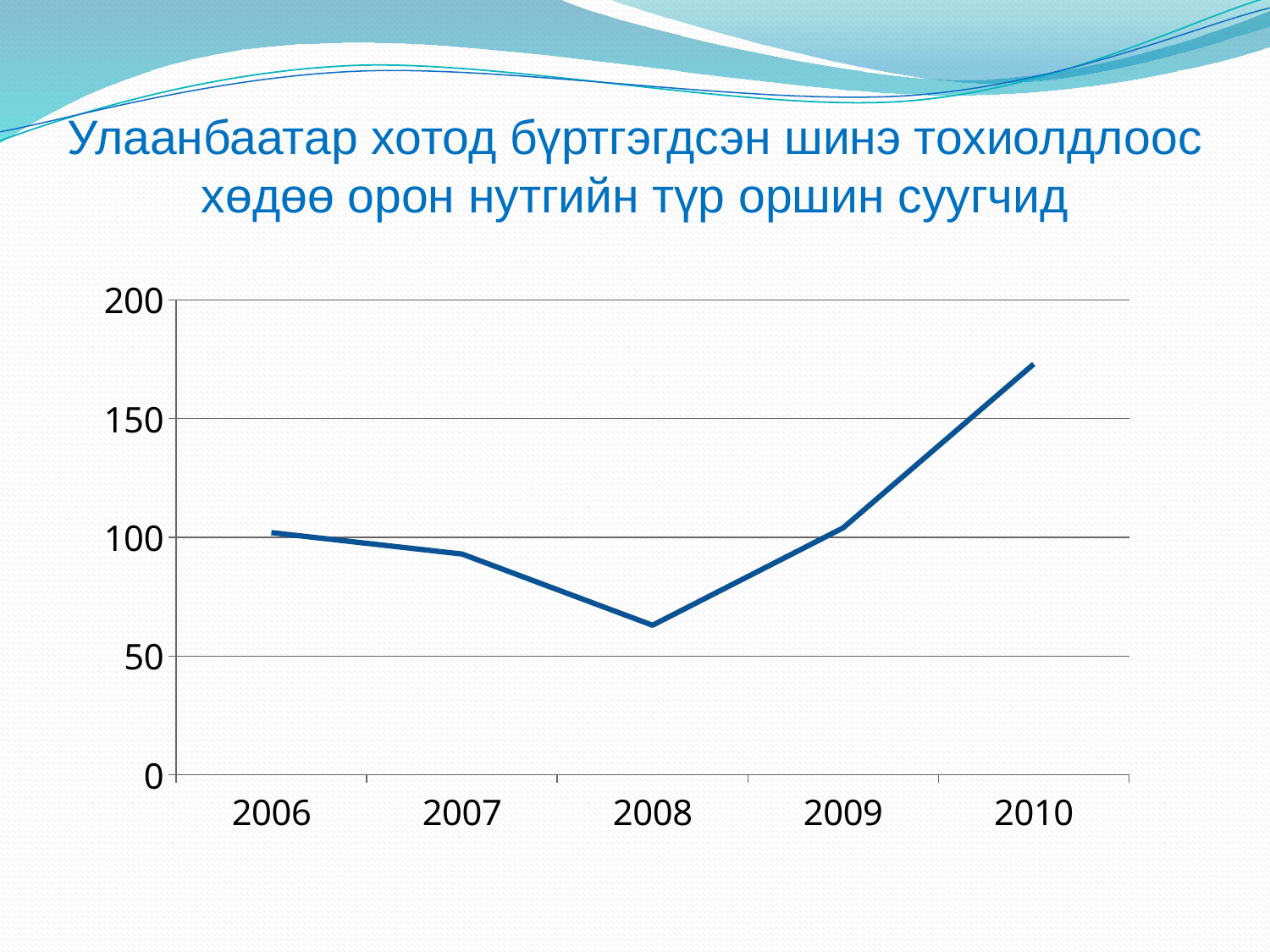
Which year has the highest value? 2010 Do the values rise or fall from 2006 to 2008? fall Is the value for 2010 greater or less than 150? greater Do the values rise or fall from 2008 to 2010? rise Which is larger, the value for 2007 or the value for 2008? 2007 Is the value for 2008 greater or less than 100? less What kind of chart is shown on the slide? line chart How many years are plotted on the x axis? 5 Is the value for 2007 greater or less than 100? less Which year has the lowest value? 2008 Which is larger, the value for 2009 or the value for 2010? 2010